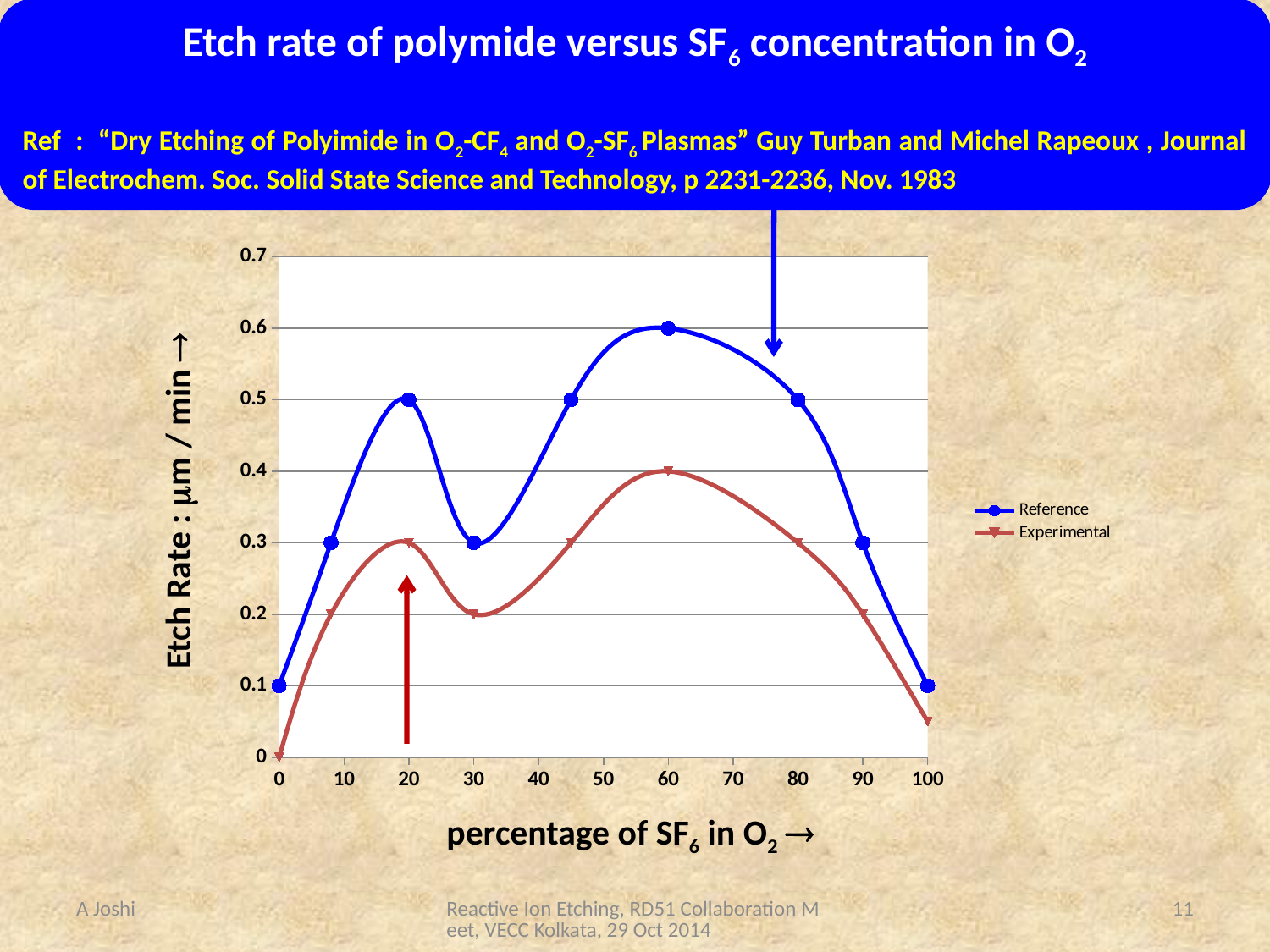
What is the difference between the Reference and Experimental etch rates at 60% SF6 in O2? 0.2 What is the Experimental etch rate at 60% SF6 in O2? 0.4 At what percentage of SF6 in O2 does the Reference series reach its highest etch rate? 60 Is the Experimental etch rate at 100% SF6 in O2 greater or less than 0.1? less What colour is the Reference series line? blue Does the Reference etch rate rise or fall as the percentage of SF6 goes from 60 to 100? fall What is the Reference etch rate at 60% SF6 in O2? 0.6 At 20% SF6 in O2, which series has the higher etch rate, Reference or Experimental? Reference What is the Reference etch rate at 20% SF6 in O2? 0.5 How many series does the legend list? 2 What kind of chart is shown on the slide? line chart What is the Experimental etch rate at 30% SF6 in O2? 0.2